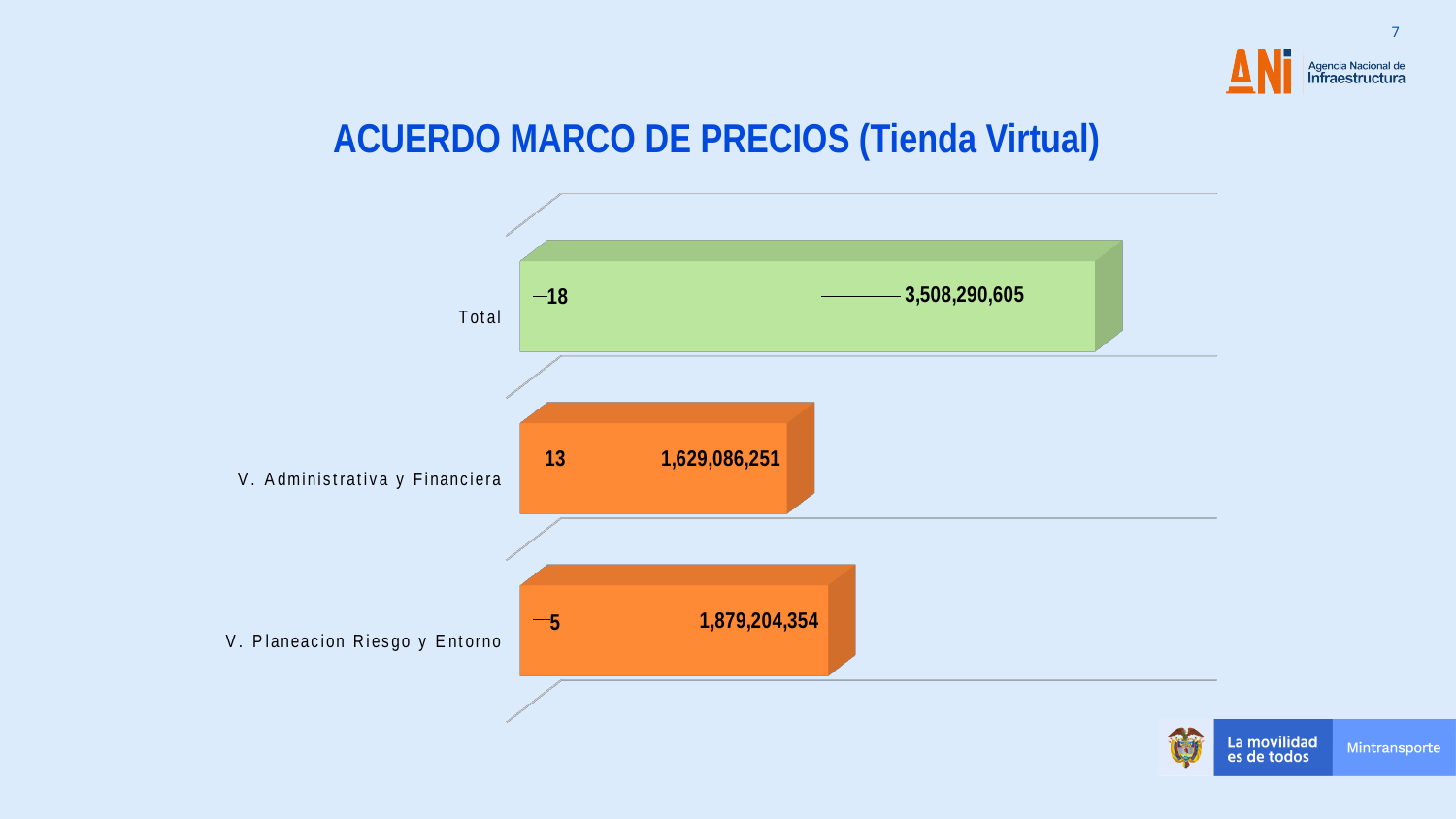
What count is labelled on the V. Planeacion Riesgo y Entorno bar? 5 What amount is shown for V. Planeacion Riesgo y Entorno? 1,879,204,354 Excluding the Total bar, which category has the smaller amount? V. Administrativa y Financiera How many bars are shown in the chart? 3 Which has the larger count, V. Administrativa y Financiera or V. Planeacion Riesgo y Entorno? V. Administrativa y Financiera What amount is shown for the Total bar? 3,508,290,605 Excluding the Total bar, which category has the larger amount? V. Planeacion Riesgo y Entorno What is the difference between the amounts for V. Planeacion Riesgo y Entorno and V. Administrativa y Financiera? 250,118,103 What amount is shown for V. Administrativa y Financiera? 1,629,086,251 What count is labelled on the V. Administrativa y Financiera bar? 13 What type of chart is shown on the slide? Bar chart What count is labelled on the Total bar? 18